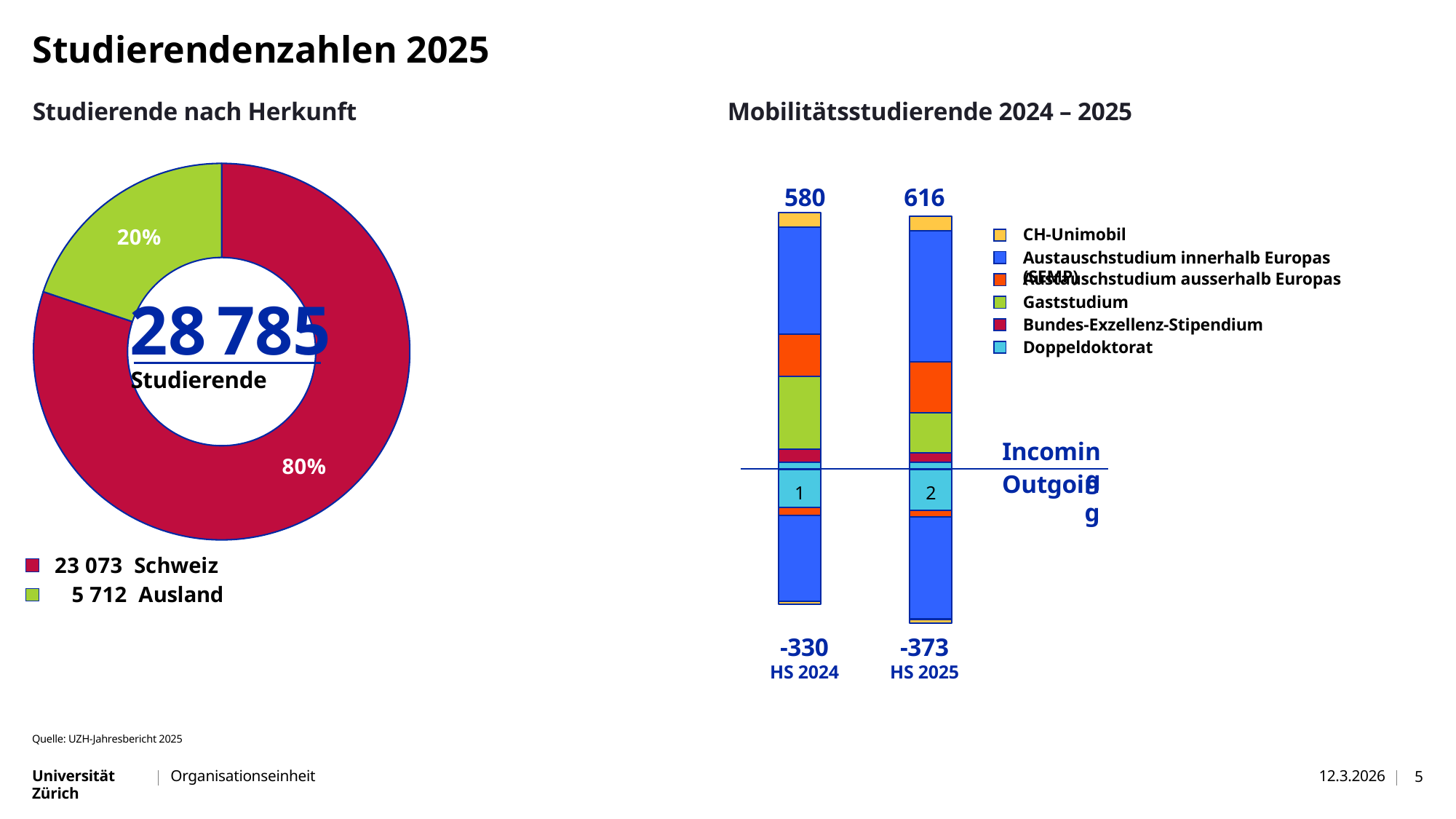
In the 'Studierende nach Herkunft' chart, what share of students come from Schweiz? 80% In the 'Mobilitätsstudierende 2024 – 2025' chart, by how much did the incoming total increase from HS 2024 to HS 2025? 36 In the 'Mobilitätsstudierende 2024 – 2025' chart, which semester has the larger incoming total, HS 2024 or HS 2025? HS 2025 In the 'Studierende nach Herkunft' chart, what is the total number of Studierende shown in the centre? 28 785 In the 'Studierende nach Herkunft' chart, how many students are from Ausland? 5 712 In the 'Mobilitätsstudierende 2024 – 2025' chart, what is the outgoing total for HS 2024? -330 What kind of chart is 'Mobilitätsstudierende 2024 – 2025'? stacked bar chart In the 'Studierende nach Herkunft' chart, what is the difference between the Schweiz and Ausland student numbers? 17 361 What kind of chart is 'Studierende nach Herkunft'? donut chart In the 'Mobilitätsstudierende 2024 – 2025' chart, what is the incoming total for HS 2025? 616 How many series does the legend of the 'Mobilitätsstudierende 2024 – 2025' chart list? 6